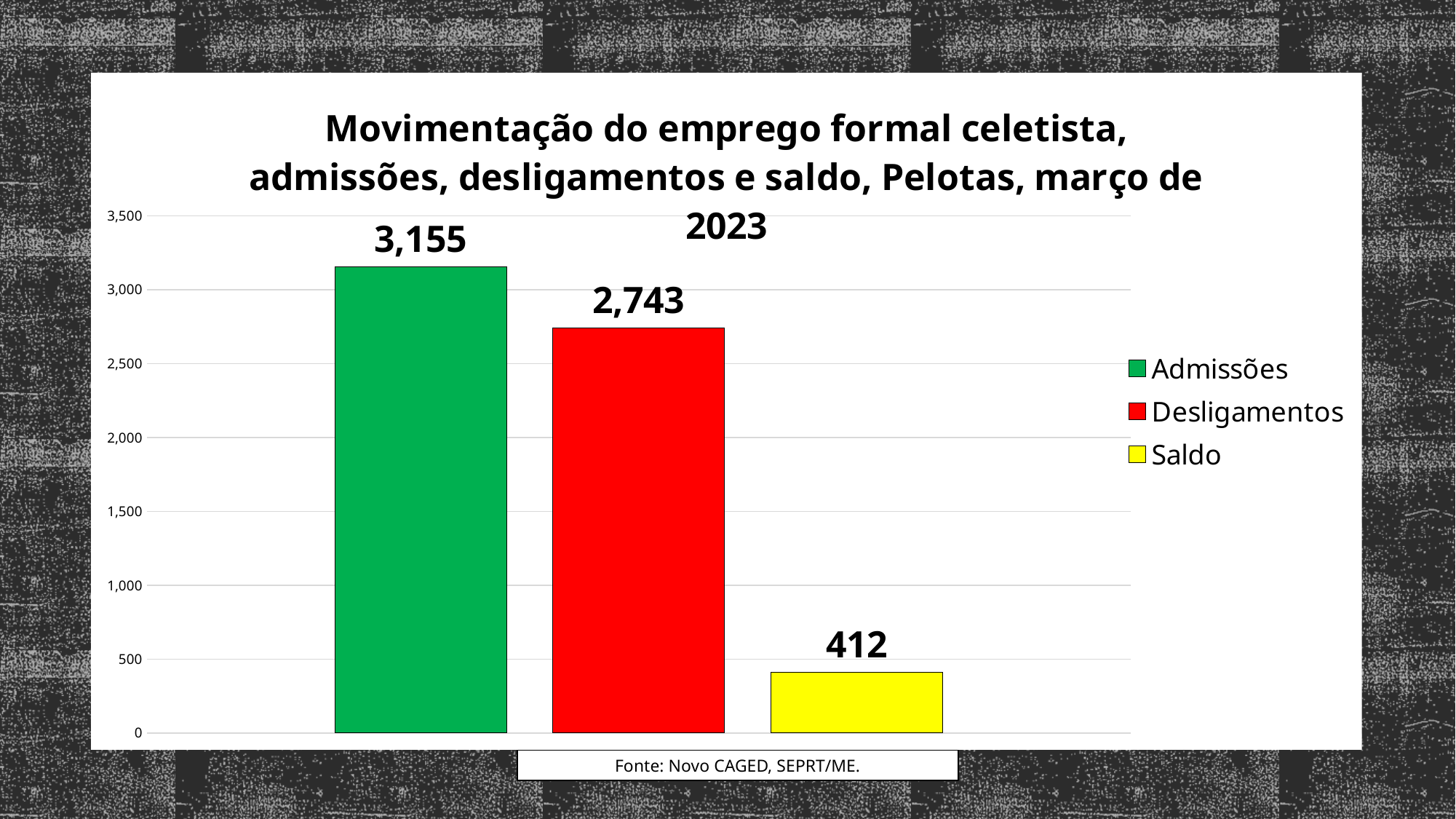
What kind of chart is shown on the slide? bar chart What is the value for Admissões? 3,155 Which series has the highest value? Admissões What colour is the bar for Saldo? yellow Is the value for Desligamentos greater or less than 3,000? less Which is larger, Desligamentos or Saldo? Desligamentos What is the value for Desligamentos? 2,743 Which series has the lowest value? Saldo What is the value for Saldo? 412 How many bars are plotted in the chart? 3 What is the difference between Admissões and Desligamentos? 412 How many series does the legend list? 3